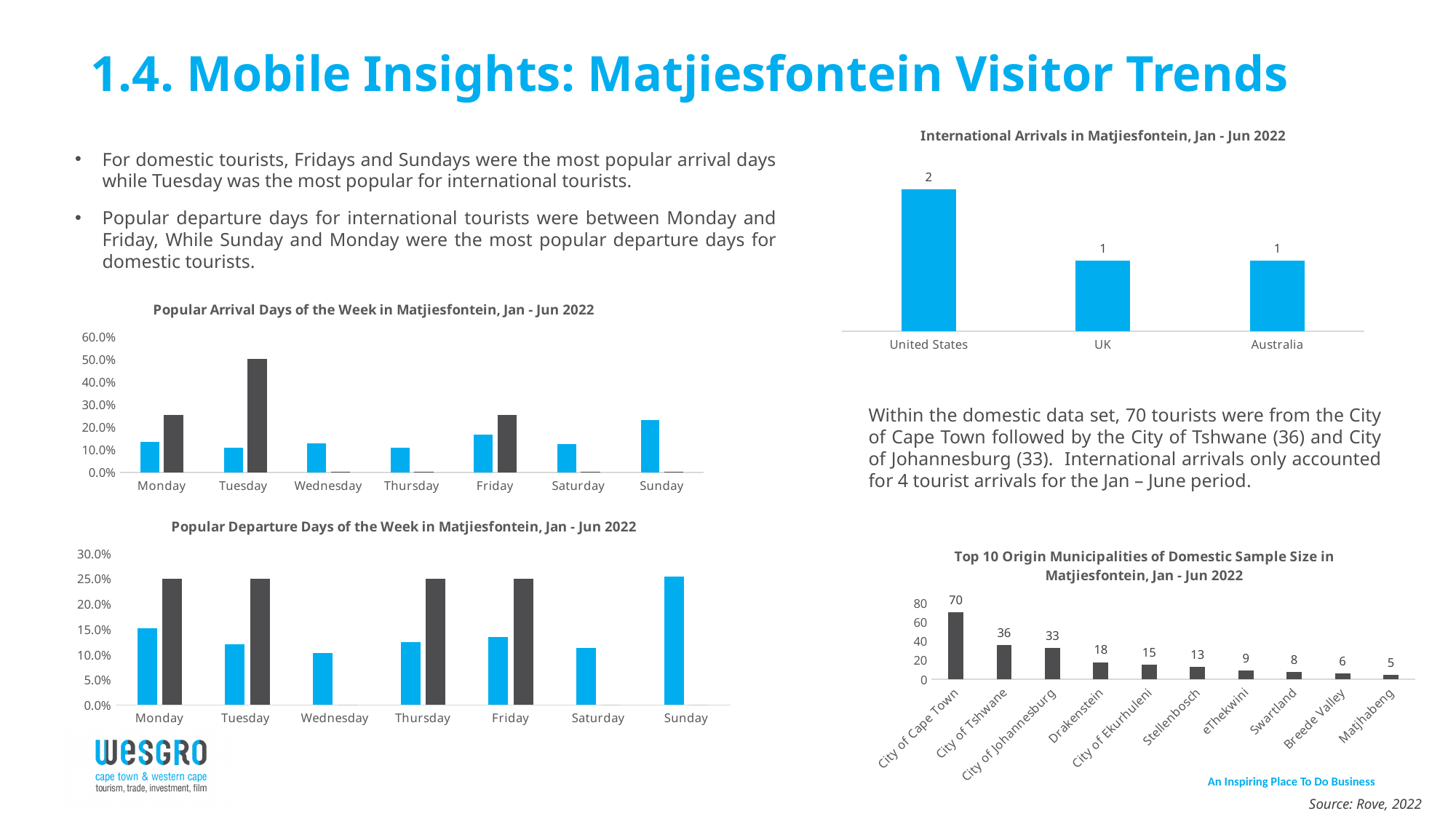
In the International Arrivals in Matjiesfontein chart, how many countries are shown? 3 In the Top 10 Origin Municipalities chart, what is the value for Drakenstein? 18 In the International Arrivals in Matjiesfontein chart, which country has the highest value? United States In the Popular Arrival Days of the Week chart, is the value of the dark grey bar for Tuesday greater or less than 40.0%? greater In the Top 10 Origin Municipalities chart, which is larger, Stellenbosch or eThekwini? Stellenbosch In the Top 10 Origin Municipalities chart, what is the value for City of Cape Town? 70 What kind of chart is the Popular Departure Days of the Week in Matjiesfontein chart? bar chart In the Top 10 Origin Municipalities chart, what is the difference between City of Cape Town and City of Tshwane? 34 In the Top 10 Origin Municipalities chart, which municipality has the lowest value? Matjhabeng In the International Arrivals in Matjiesfontein chart, what is the difference between United States and UK? 1 In the International Arrivals in Matjiesfontein chart, what is the value for United States? 2 In the Top 10 Origin Municipalities chart, do the values rise or fall from left to right? fall